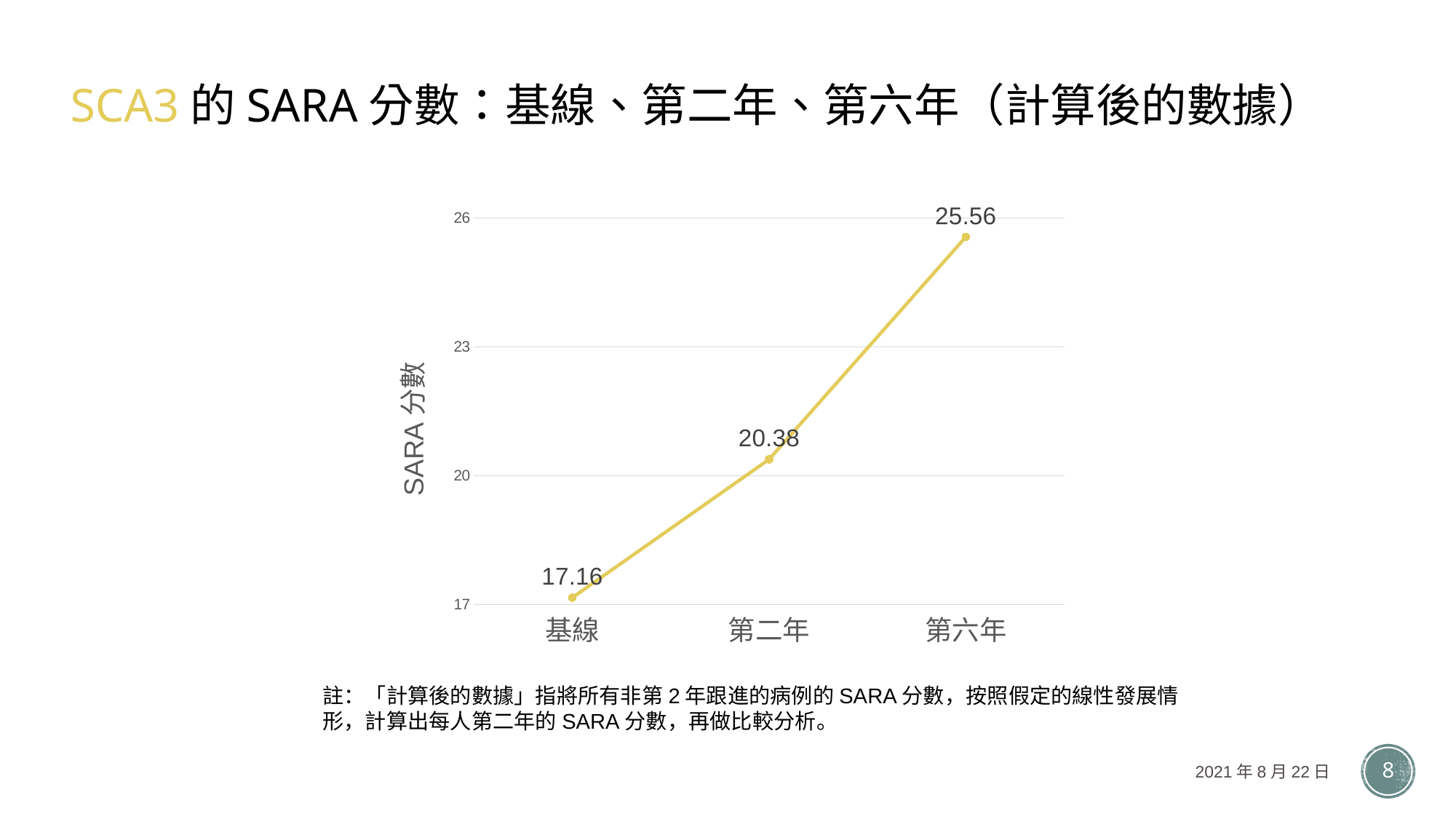
What is the SARA score at 基線 (baseline)? 17.16 What is the SARA score at 第二年? 20.38 Which is larger, the SARA score at 第二年 or at 第六年? 第六年 Which time point has the lowest SARA score? 基線 How many time points are plotted on the chart? 3 What kind of chart is shown on the slide? line chart What is the SARA score at 第六年? 25.56 What is the difference between the SARA score at 第六年 and at 基線? 8.40 Which time point has the highest SARA score? 第六年 What is the difference between the SARA score at 第二年 and at 基線? 3.22 Is the SARA score at 第二年 greater or less than 20? greater Do the SARA scores rise or fall from 基線 to 第六年? rise